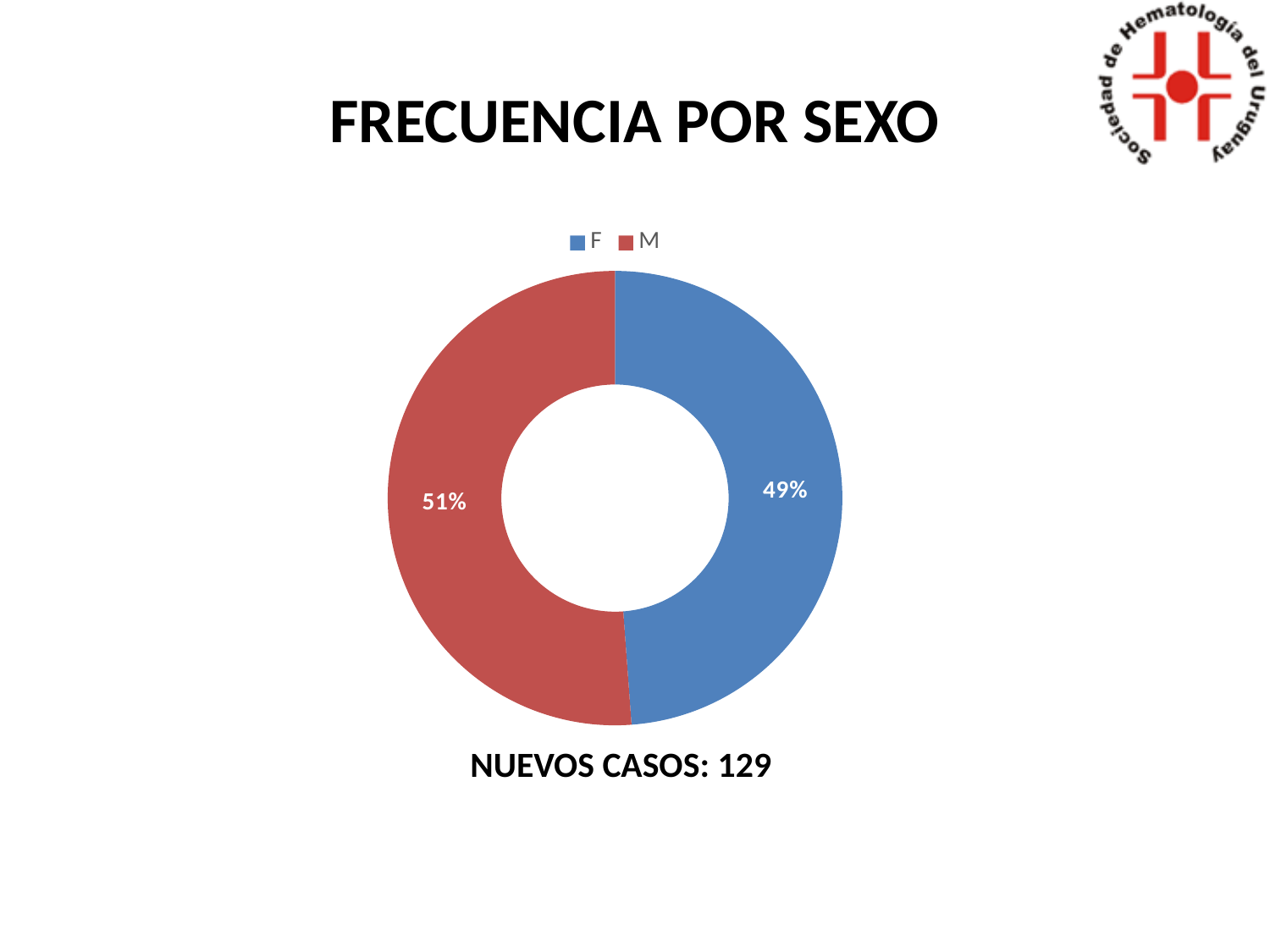
Which colour represents the F category in the chart? Blue What kind of chart is shown on the slide? Doughnut (pie) chart Which is larger, the share for F or the share for M? M What share of the pie does the M slice represent? 51% Is the share for M greater or less than 50%? greater How many entries does the legend list? 2 What is the title of the chart on the slide? FRECUENCIA POR SEXO Which category has the largest share in the chart? M How many categories (slices) does the chart show? 2 Which category has the smallest share in the chart? F What share of the pie does the F slice represent? 49% What is the difference in percentage points between the M share and the F share? 2 percentage points